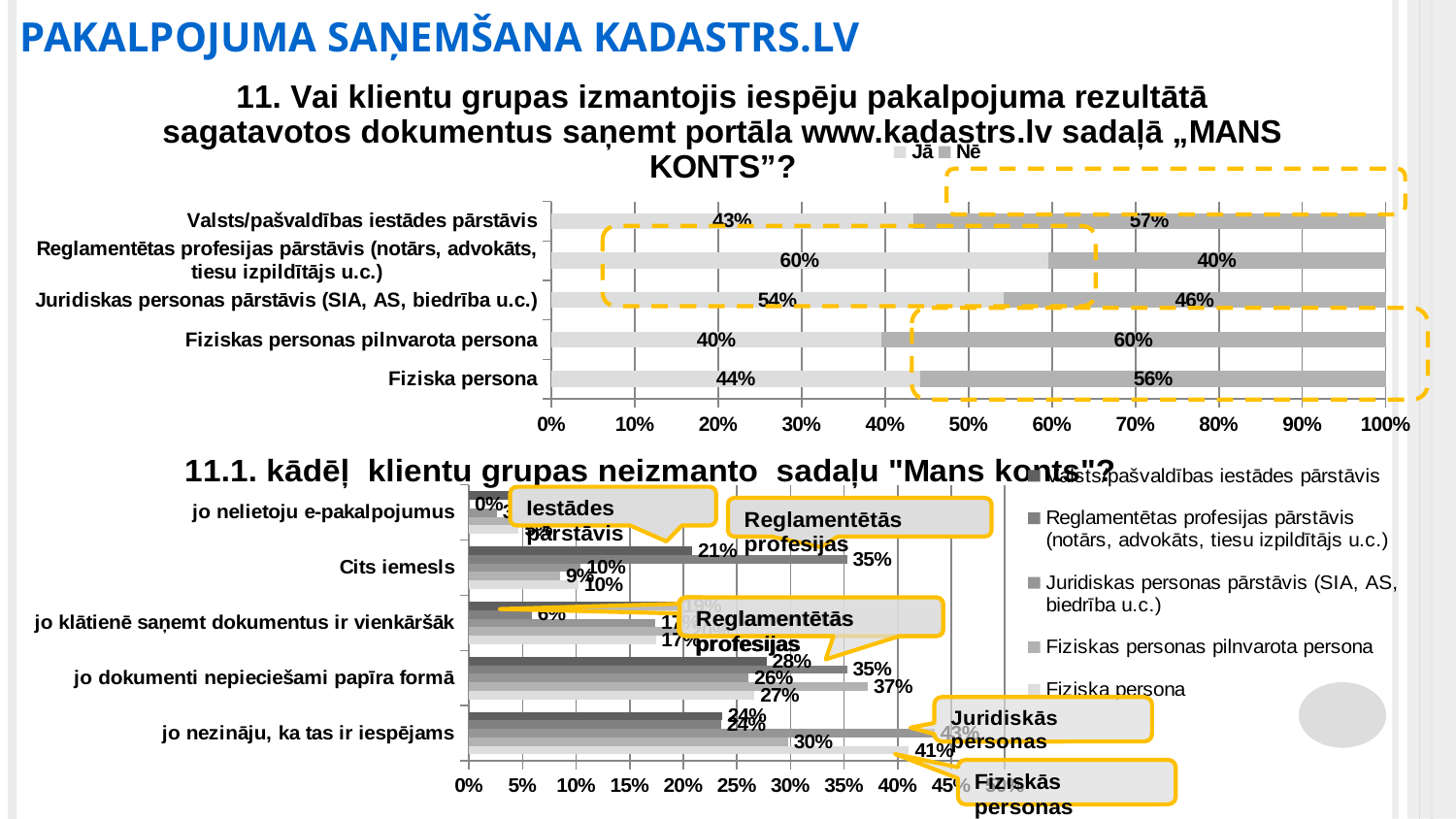
In the top chart (question 11), which client group has the highest Jā share? Reglamentētas profesijas pārstāvis (notārs, advokāts, tiesu izpildītājs u.c.) In the top chart (question 11), what is the Jā value for Juridiskas personas pārstāvis? 54% In the top chart (question 11), which client group has the lowest Jā share? Fiziskas personas pilnvarota persona In the top chart (question 11), what percentage of Valsts/pašvaldības iestādes pārstāvis answered Jā? 43% In the top chart (question 11), what do the Jā and Nē values for Valsts/pašvaldības iestādes pārstāvis add up to? 100% In the top chart (question 11), what is the difference between the Nē and Jā values for Fiziska persona? 12% In the top chart (question 11), what is the Nē value for Fiziskas personas pilnvarota persona? 60% How many series does the legend of the bottom chart (question 11.1) list? 5 In the top chart (question 11), is the Jā value larger for Juridiskas personas pārstāvis or for Fiziska persona? Juridiskas personas pārstāvis In the top chart (question 11), what percentage of Reglamentētas profesijas pārstāvis answered Nē? 40% What type of chart is the bottom chart (question 11.1)? Bar chart How many series does the legend of the top chart (question 11) list? 2